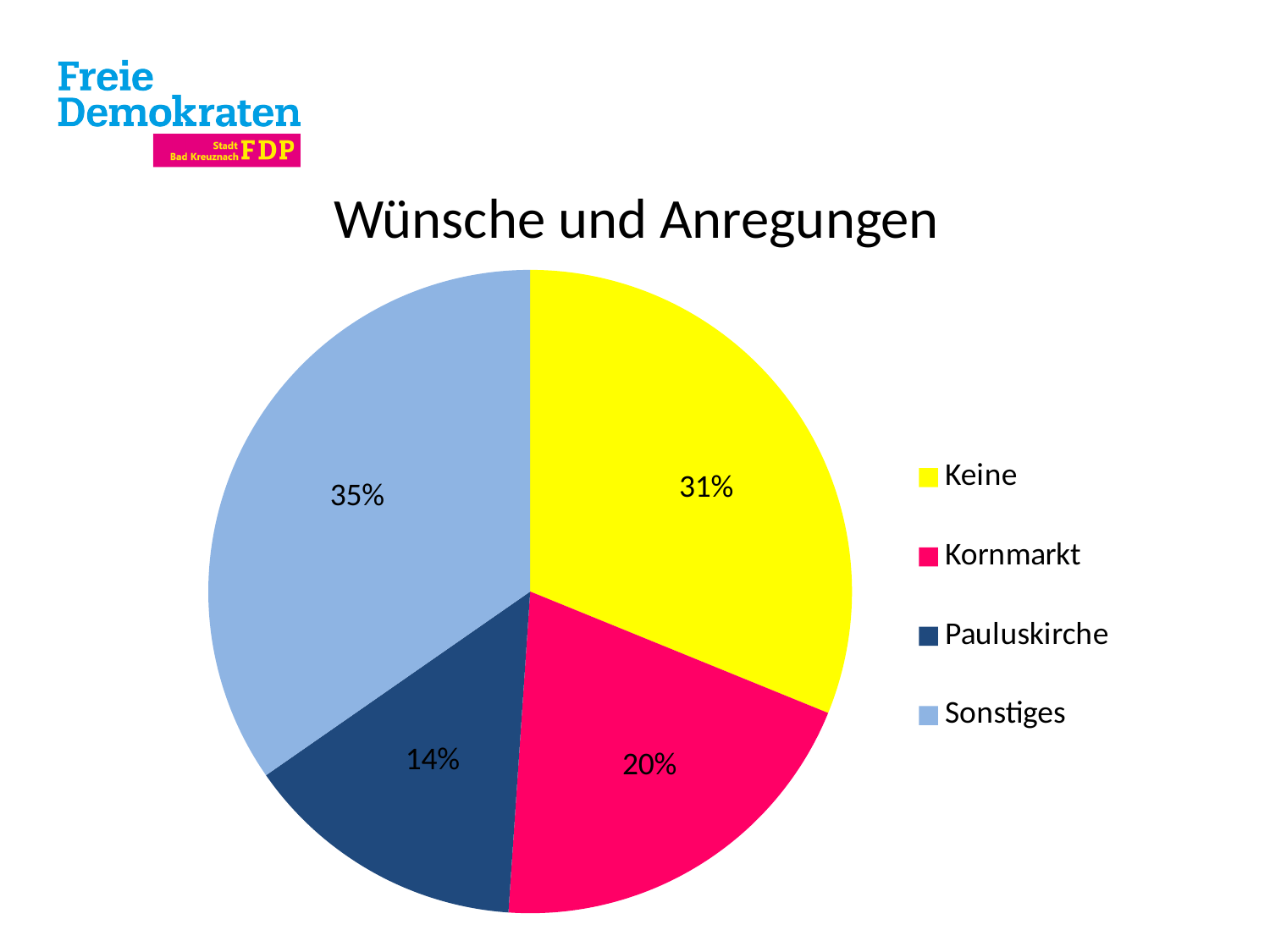
What is the title of the chart? Wünsche und Anregungen What share of the pie does Sonstiges have? 35% What share of the pie does Keine have? 31% What share of the pie does Pauluskirche have? 14% What is the difference in percentage points between Kornmarkt and Pauluskirche? 6 What is the difference in percentage points between Sonstiges and Keine? 4 How many categories are shown in the pie chart? 4 Which is larger, the slice for Keine or the slice for Kornmarkt? Keine Which category has the largest slice of the pie? Sonstiges What kind of chart is shown on the slide? Pie chart Which category has the smallest slice of the pie? Pauluskirche What share of the pie does Kornmarkt have? 20%